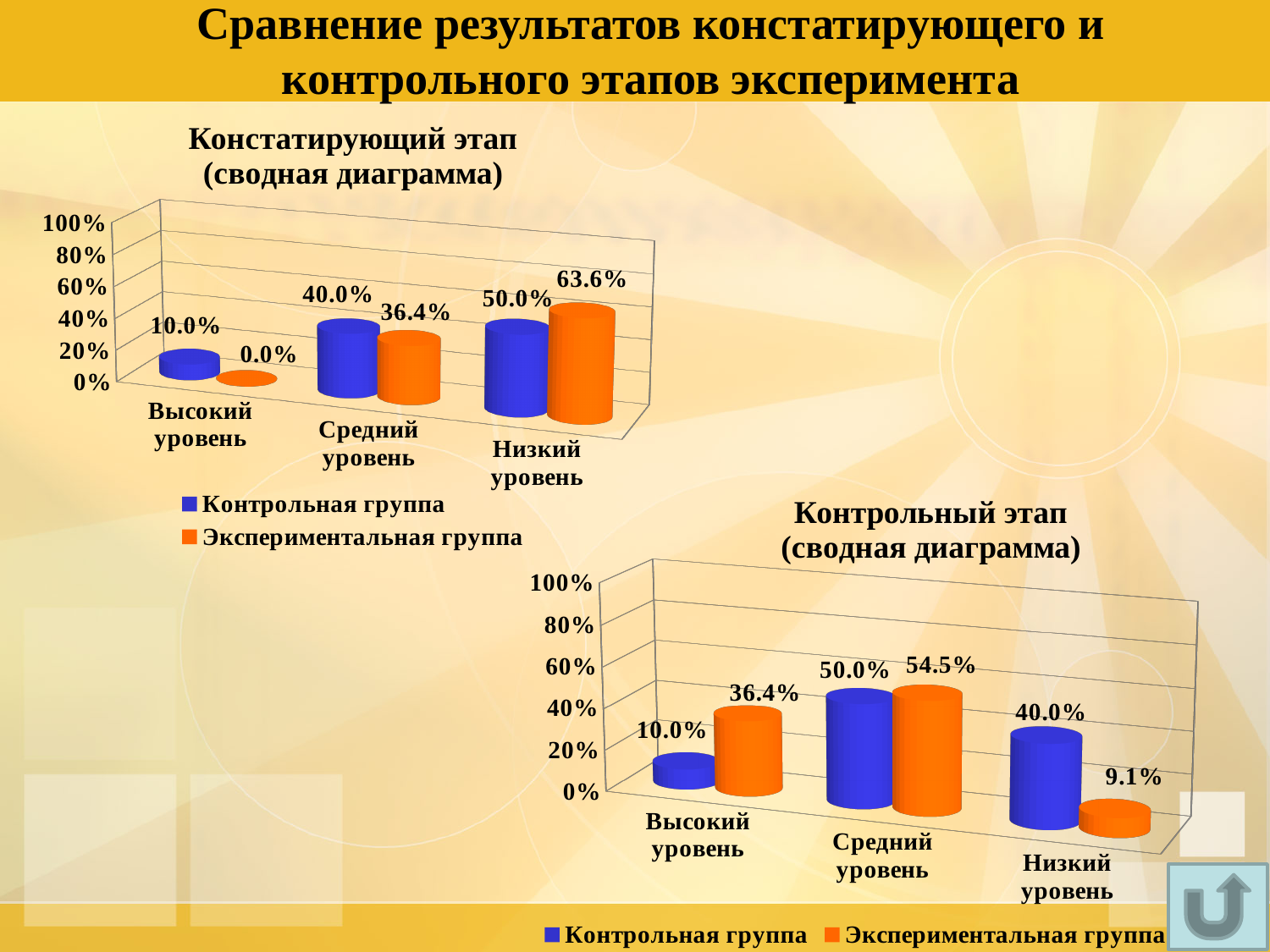
In the chart titled "Контрольный этап (сводная диаграмма)", which category has the highest value for Экспериментальная группа? Средний уровень In the chart titled "Контрольный этап (сводная диаграмма)", how many categories are shown on the x axis? 3 In the chart titled "Констатирующий этап (сводная диаграмма)", which is larger at Низкий уровень: Контрольная группа or Экспериментальная группа? Экспериментальная группа In the chart titled "Констатирующий этап (сводная диаграмма)", what is the value for Экспериментальная группа at Низкий уровень? 63.6% In the chart titled "Констатирующий этап (сводная диаграмма)", which category has the lowest value for Экспериментальная группа? Высокий уровень What kind of chart is the chart titled "Контрольный этап (сводная диаграмма)"? Bar chart In the chart titled "Констатирующий этап (сводная диаграмма)", what is the value for Контрольная группа at Средний уровень? 40.0% In the chart titled "Контрольный этап (сводная диаграмма)", what colour represents Контрольная группа? Blue In the chart titled "Контрольный этап (сводная диаграмма)", what is the difference between Экспериментальная группа and Контрольная группа at Средний уровень? 4.5% In the chart titled "Констатирующий этап (сводная диаграмма)", how many series does the legend list? 2 In the chart titled "Контрольный этап (сводная диаграмма)", what is the value for Экспериментальная группа at Высокий уровень? 36.4% In the chart titled "Контрольный этап (сводная диаграмма)", what is the value for Экспериментальная группа at Низкий уровень? 9.1%